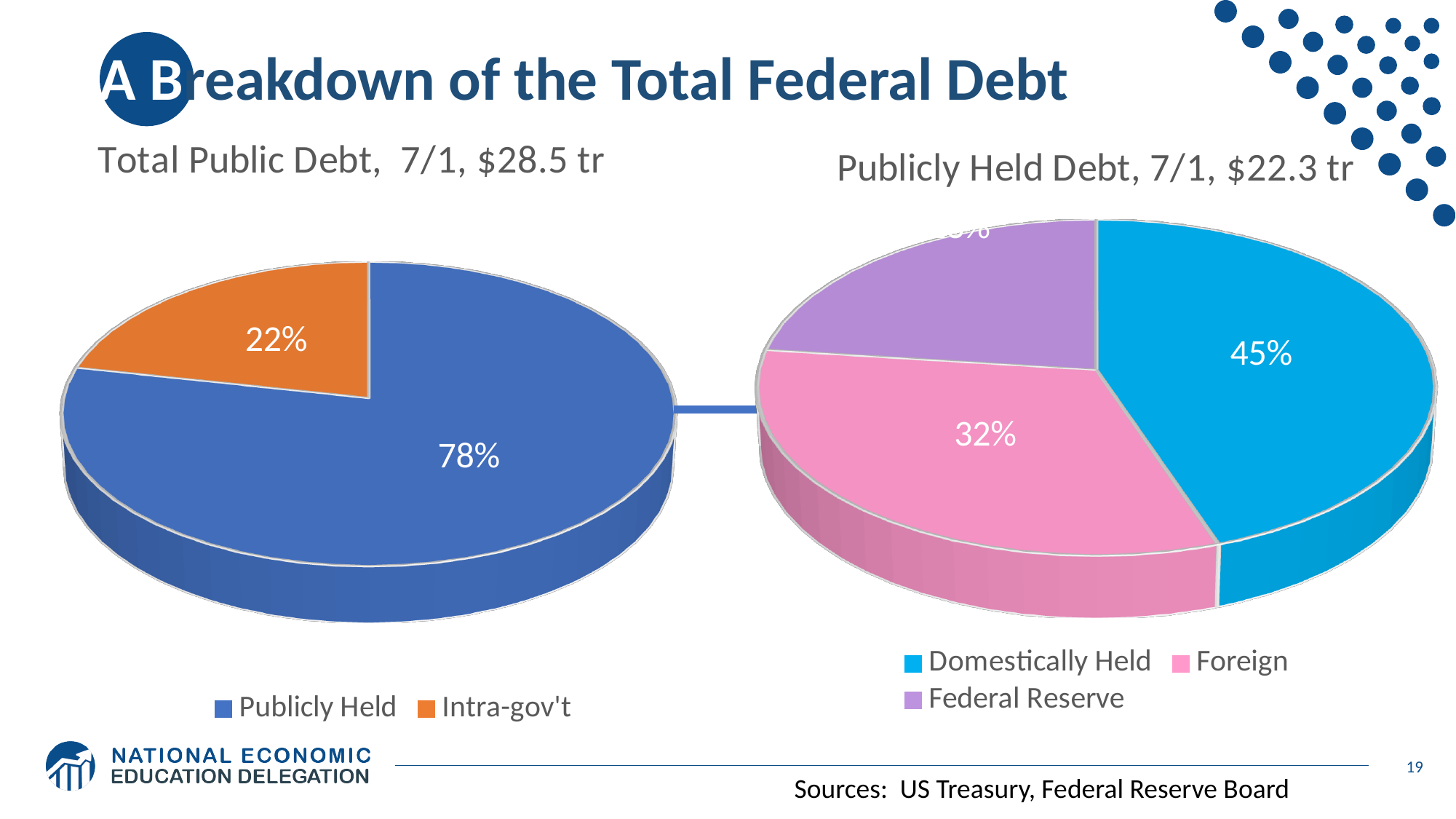
In the Publicly Held Debt chart, which slice is the largest? Domestically Held In the Total Public Debt chart, what share is Publicly Held? 78% In the Total Public Debt chart, which slice is the largest? Publicly Held In the Publicly Held Debt chart, what share is Domestically Held? 45% In the Publicly Held Debt chart, which is larger: Domestically Held or Federal Reserve? Domestically Held How many categories does the legend of the Total Public Debt chart list? 2 In the Publicly Held Debt chart, what share is Foreign? 32% What type of chart is used for the Total Public Debt chart on the left? Pie chart What total amount is given in the title of the Publicly Held Debt chart? $22.3 tr In the Total Public Debt chart, what is the difference in percentage points between Publicly Held and Intra-gov't? 56 percentage points In the Total Public Debt chart, what share is Intra-gov't? 22% How many categories does the legend of the Publicly Held Debt chart list? 3